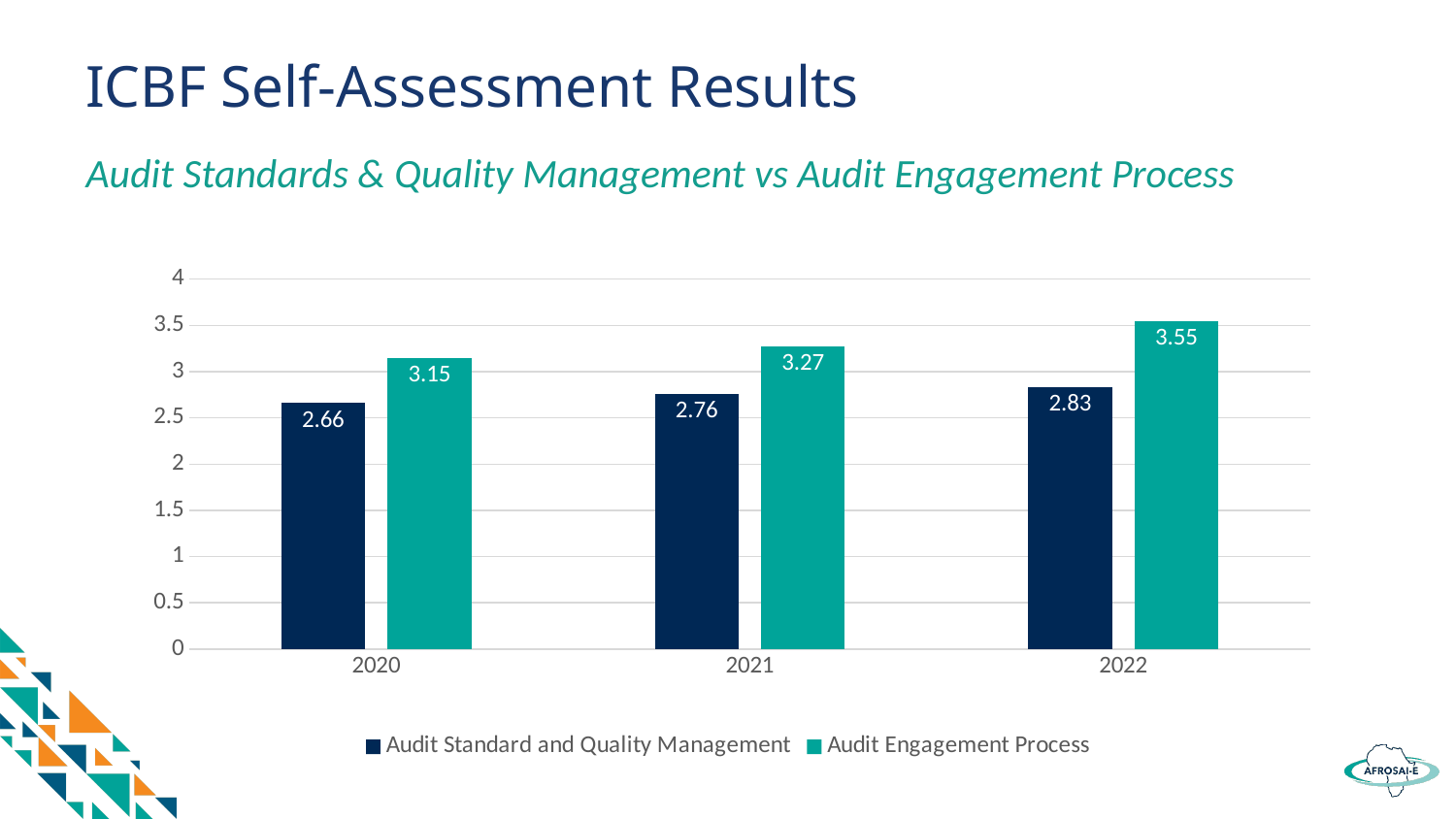
Do the Audit Standard and Quality Management values rise or fall from 2020 to 2022? rise What is the value for Audit Standard and Quality Management in 2020? 2.66 What is the difference between Audit Engagement Process and Audit Standard and Quality Management in 2022? 0.72 How many series does the legend list? 2 What kind of chart is shown on the slide? bar chart Is the value for Audit Engagement Process in 2022 greater or less than 3.5? greater What is the value for Audit Engagement Process in 2022? 3.55 What is the value for Audit Engagement Process in 2021? 3.27 How many years are shown on the x axis? 3 In which year is the Audit Standard and Quality Management value lowest? 2020 Which is larger in 2021: Audit Standard and Quality Management or Audit Engagement Process? Audit Engagement Process In which year is the Audit Engagement Process value highest? 2022